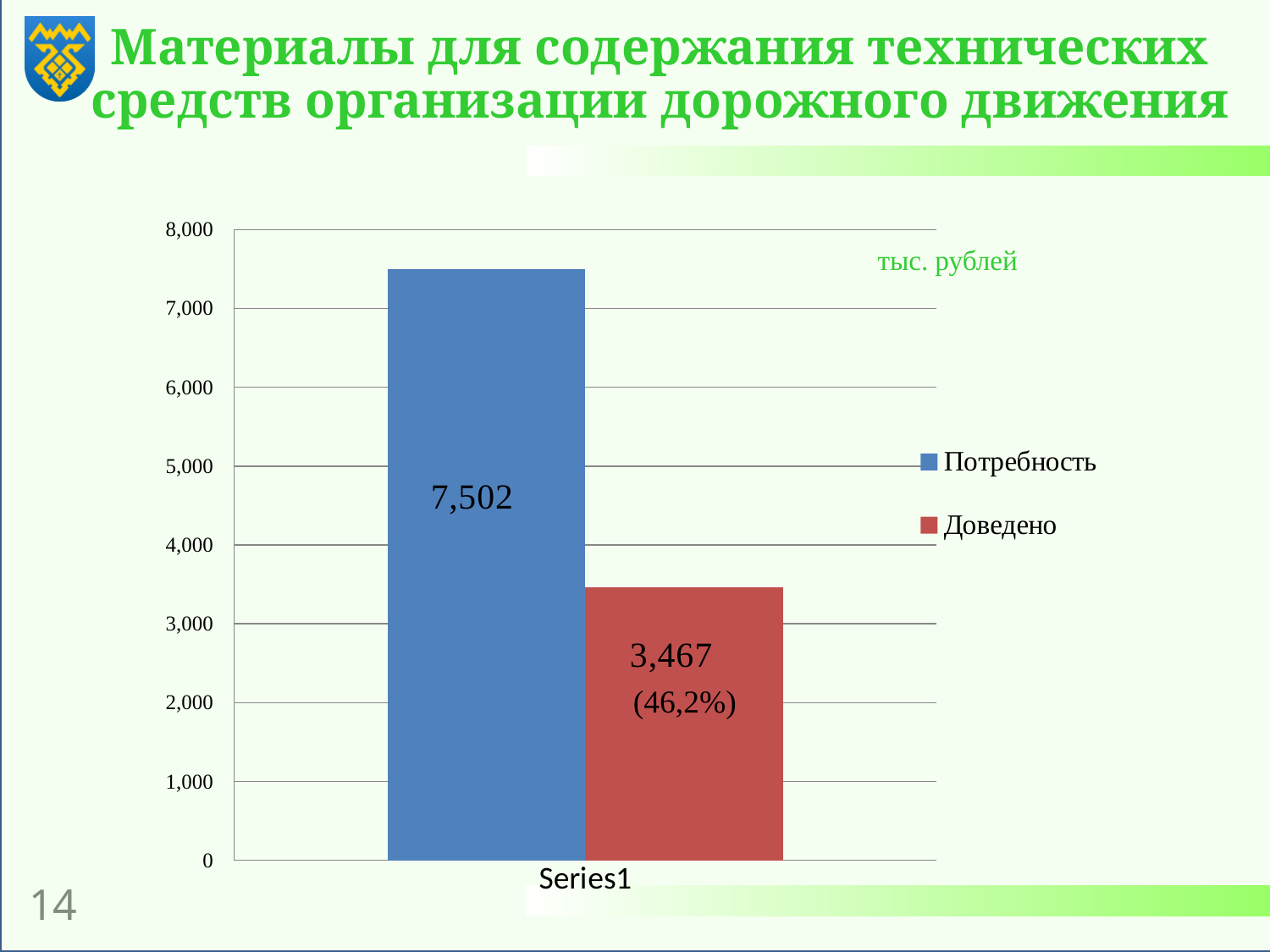
What colour is the Доведено bar? red What is the difference between the Потребность and Доведено values? 4,035 What percentage is shown in parentheses on the Доведено bar? 46,2% What is the value of the Доведено bar? 3,467 What unit is indicated in the green text on the chart? тыс. рублей Is the value for Доведено greater or less than 4,000? less Which series has the higher value, Потребность or Доведено? Потребность How many series does the legend list? 2 Is the value for Потребность greater or less than 7,000? greater Which series has the lowest value? Доведено What is the value of the Потребность bar? 7,502 What kind of chart is shown on the slide? bar chart